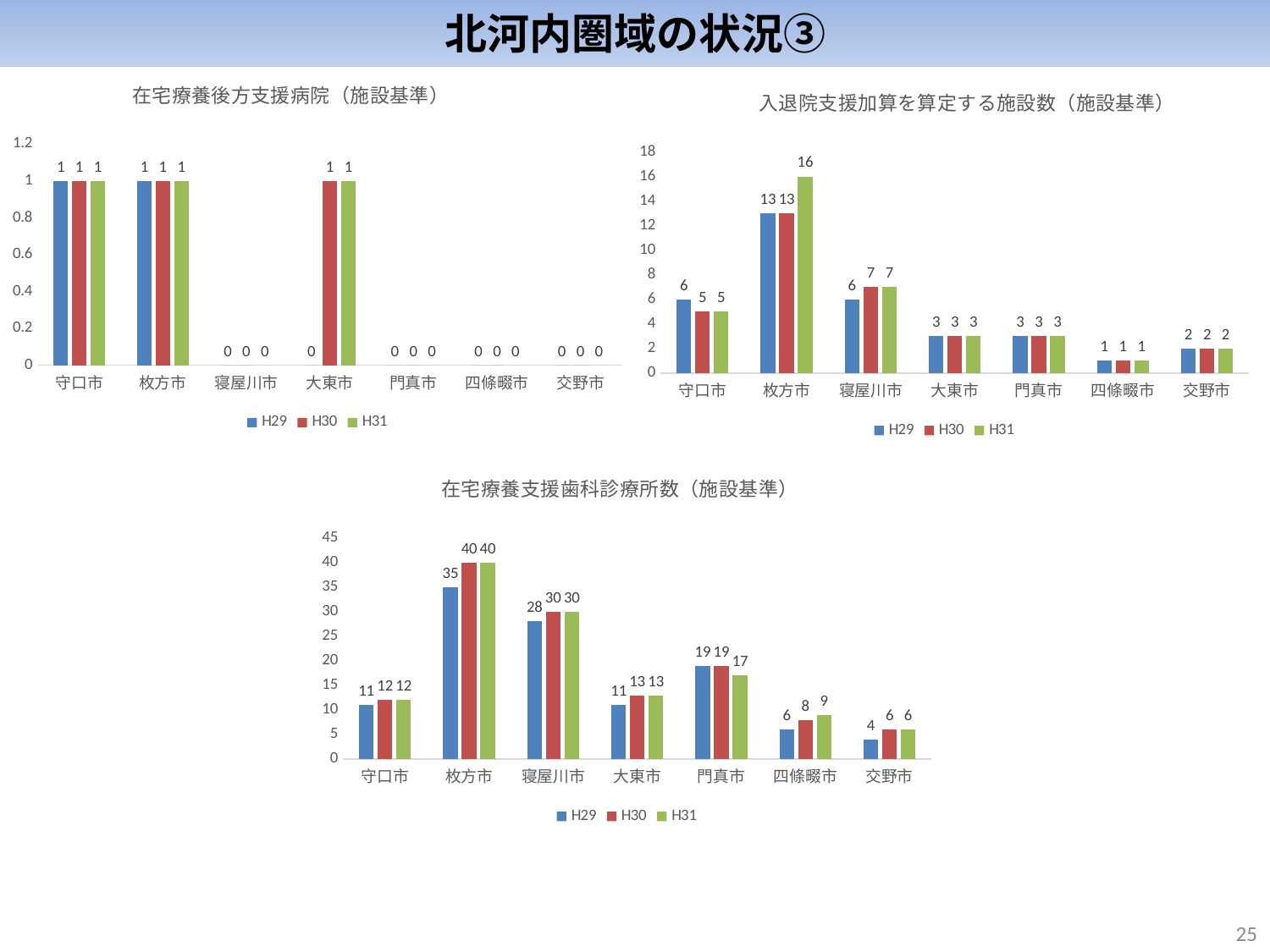
In the chart titled 入退院支援加算を算定する施設数（施設基準）, which city has the lowest H31 value? 四條畷市 In the chart titled 入退院支援加算を算定する施設数（施設基準）, which city has the highest H29 value? 枚方市 In the chart titled 入退院支援加算を算定する施設数（施設基準）, what is the difference between the H29 and H30 values for 守口市? 1 How many cities are shown on the x axis of the chart titled 在宅療養後方支援病院（施設基準）? 7 In the chart titled 入退院支援加算を算定する施設数（施設基準）, what is the H31 value for 枚方市? 16 In the chart titled 在宅療養支援歯科診療所数（施設基準）, what is the H29 value for 枚方市? 35 In the chart titled 在宅療養支援歯科診療所数（施設基準）, how do the values for 門真市 change from H29 to H31? They fall from 19 to 17 In the chart titled 在宅療養支援歯科診療所数（施設基準）, which city has the lowest H29 value? 交野市 In the chart titled 在宅療養支援歯科診療所数（施設基準）, is the H30 value for 寝屋川市 larger or smaller than the H30 value for 門真市? larger In the chart titled 在宅療養支援歯科診療所数（施設基準）, what is the difference between the H31 and H29 values for 四條畷市? 3 How many series does the legend list in the chart titled 在宅療養支援歯科診療所数（施設基準）? 3 In the chart titled 在宅療養後方支援病院（施設基準）, what is the H29 value for 大東市? 0